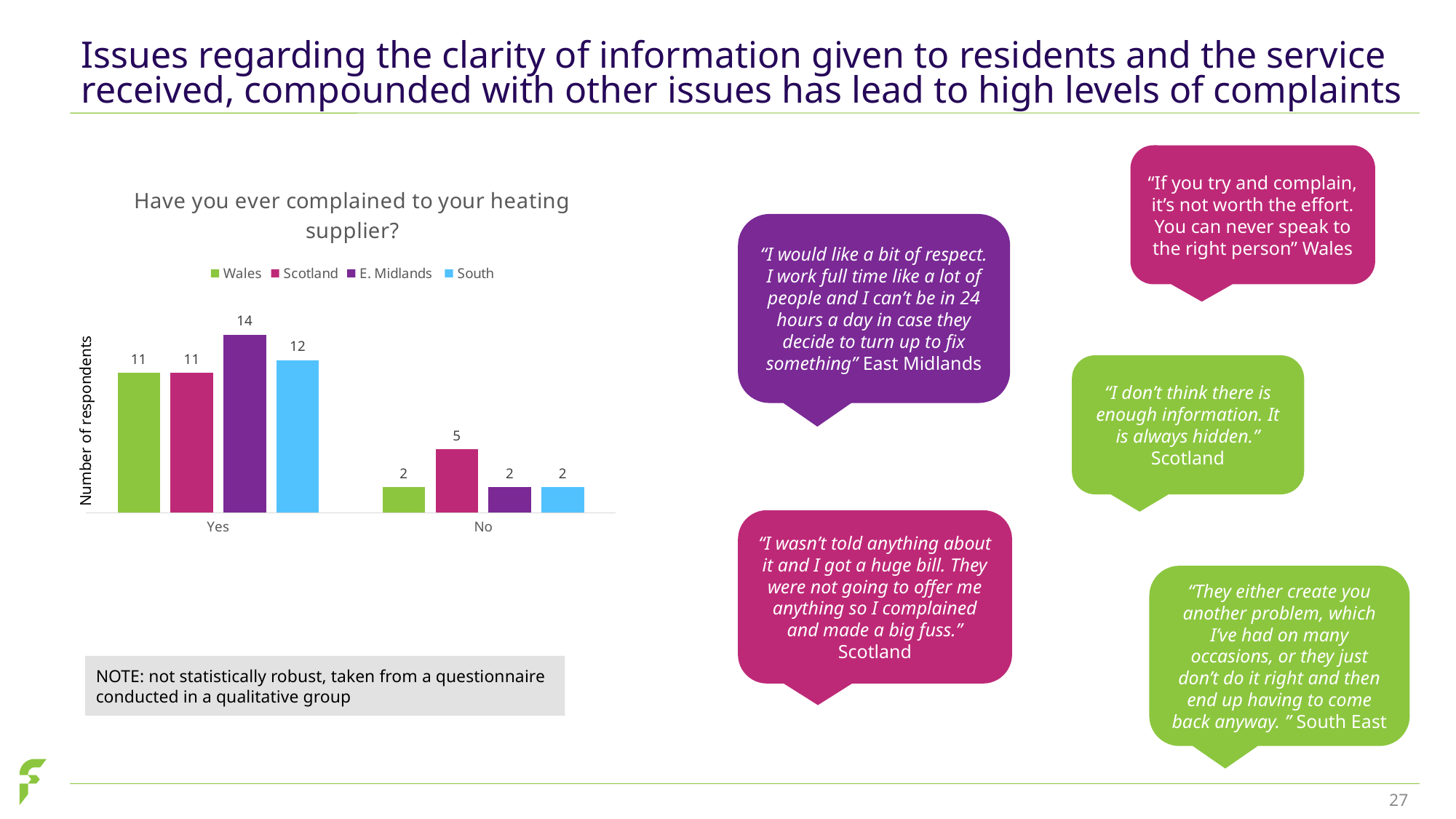
What is the label of the y axis? Number of respondents What is the title of the chart? Have you ever complained to your heating supplier? Which is larger: the Yes value for South or the Yes value for Wales? South Which region has the highest number of No responses? Scotland Which region has the highest number of Yes responses? E. Midlands How many series does the legend list? 4 How many respondents from E. Midlands answered Yes? 14 What type of chart is shown on the slide? Bar chart What is the difference between the Yes and No responses for Wales? 9 How many respondents from South answered Yes? 12 How many respondents from Scotland answered No? 5 How many answer categories are shown on the x axis? 2